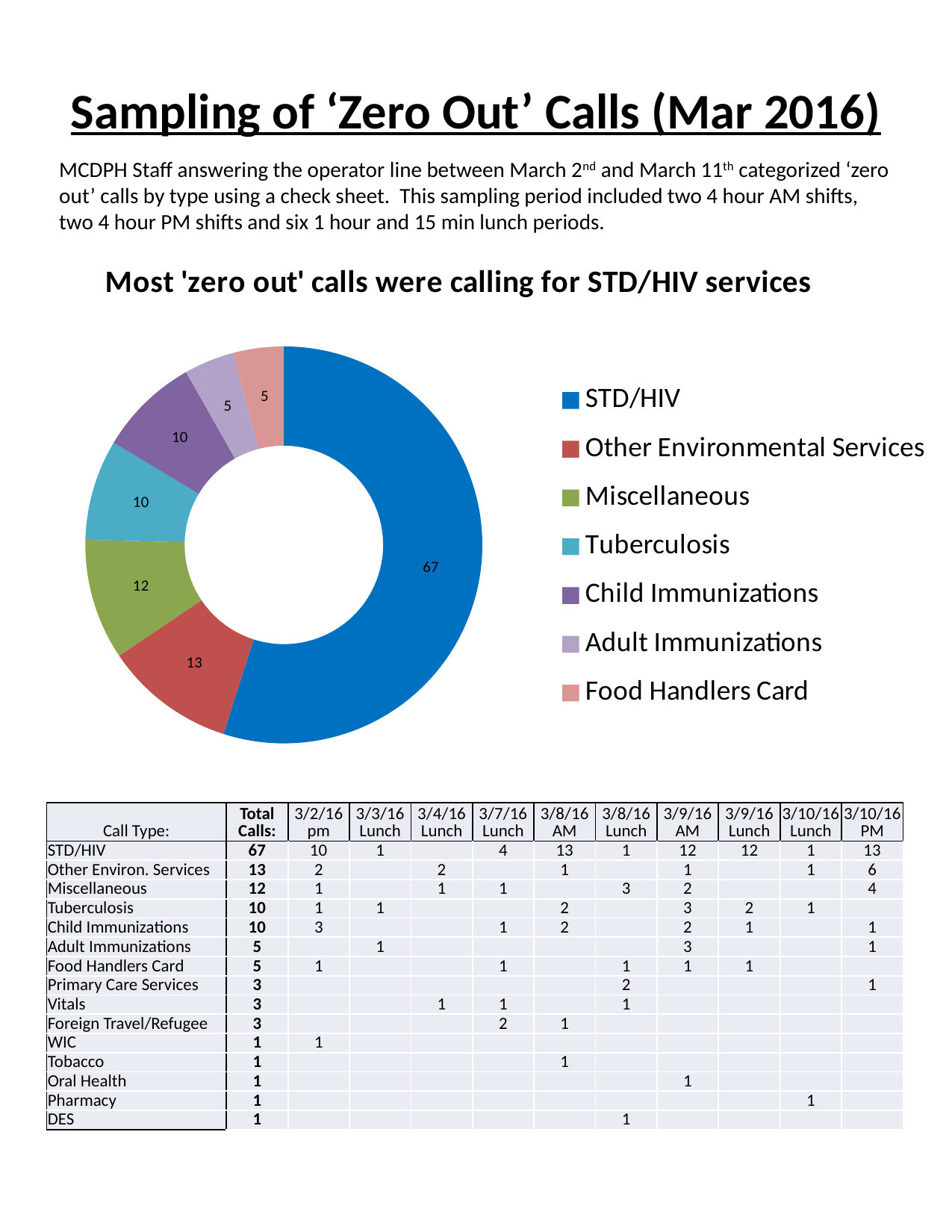
Which category has the highest value in the doughnut chart? STD/HIV What is the title of the doughnut chart? Most 'zero out' calls were calling for STD/HIV services What kind of chart is shown on the slide? Doughnut chart What is the value for STD/HIV in the doughnut chart? 67 Which is larger, the value for Other Environmental Services or the value for Child Immunizations? Other Environmental Services What is the value for Miscellaneous in the doughnut chart? 12 What is the difference between the values for STD/HIV and Other Environmental Services? 54 What is the value for Food Handlers Card in the doughnut chart? 5 What is the difference between the values for Miscellaneous and Adult Immunizations? 7 How many categories does the legend of the doughnut chart list? 7 What is the value for Other Environmental Services in the doughnut chart? 13 What is the value for Tuberculosis in the doughnut chart? 10